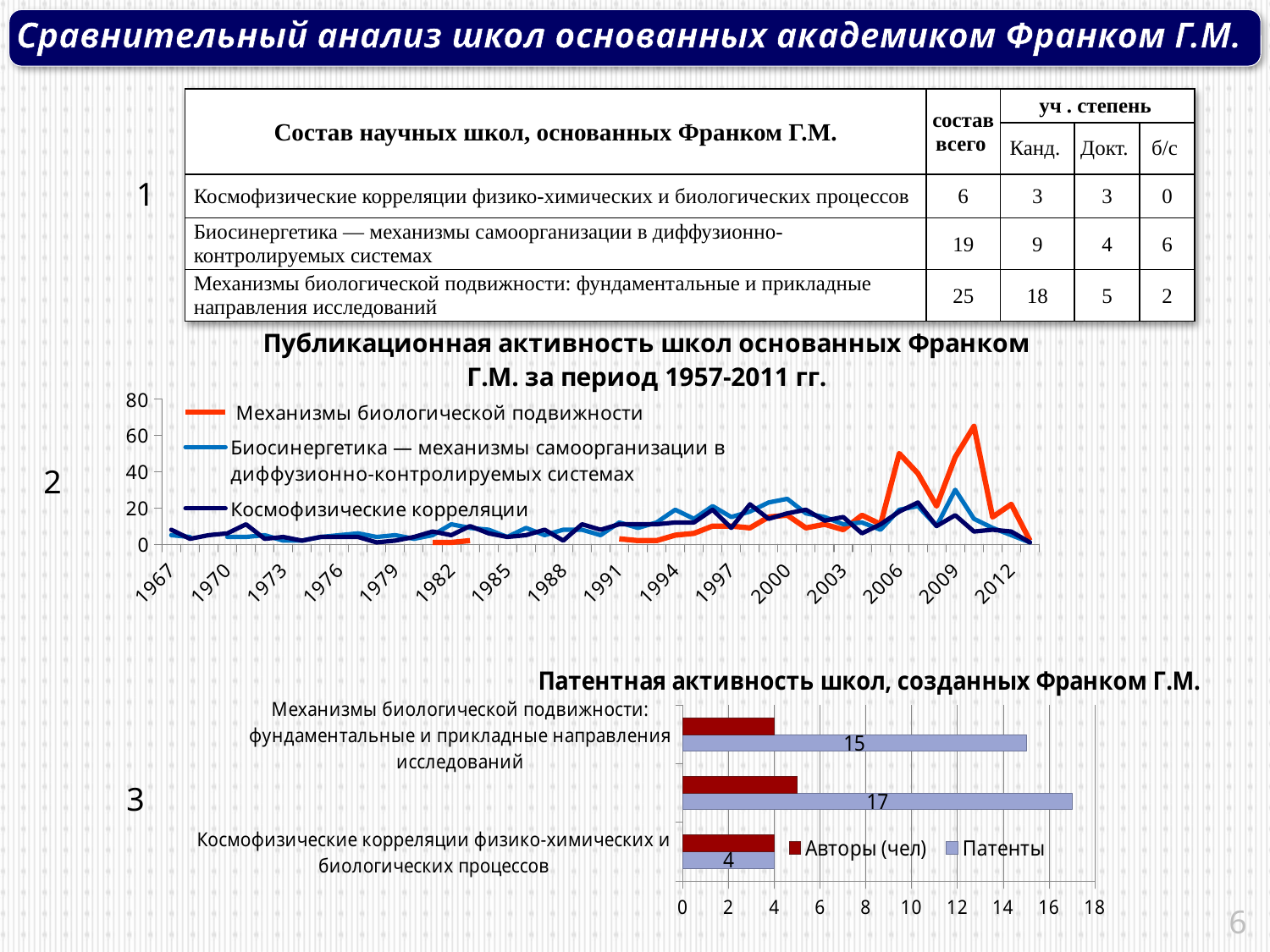
In the bar chart 'Патентная активность школ...', how many series does the legend list? 2 In the bar chart 'Патентная активность школ...', which has more Патенты: 'Механизмы биологической подвижности' or 'Космофизические корреляции'? Механизмы биологической подвижности In the line chart 'Публикационная активность школ...', is the peak value of 'Механизмы биологической подвижности' around 2010 greater or less than 40? greater In the bar chart 'Патентная активность школ...', how many categories (groups of bars) are shown? 3 In the bar chart 'Патентная активность школ...', what is the difference in Патенты between 'Механизмы биологической подвижности' and 'Космофизические корреляции'? 11 In the bar chart 'Патентная активность школ...', what is the value of Патенты for 'Космофизические корреляции физико-химических и биологических процессов'? 4 In the bar chart 'Патентная активность школ...', what is the value of Патенты for 'Механизмы биологической подвижности: фундаментальные и прикладные направления исследований'? 15 What kind of chart is the middle chart titled 'Публикационная активность школ основанных Франком Г.М. за период 1957-2011 гг.'? line chart In the line chart 'Публикационная активность школ...', which series reaches the highest value on the chart? Механизмы биологической подвижности In the bar chart 'Патентная активность школ...', is the value of Авторы (чел) for 'Космофизические корреляции' greater or less than 6? less In the line chart 'Публикационная активность школ...', how many series does the legend list? 3 What kind of chart is the bottom chart titled 'Патентная активность школ, созданных Франком Г.М.'? bar chart